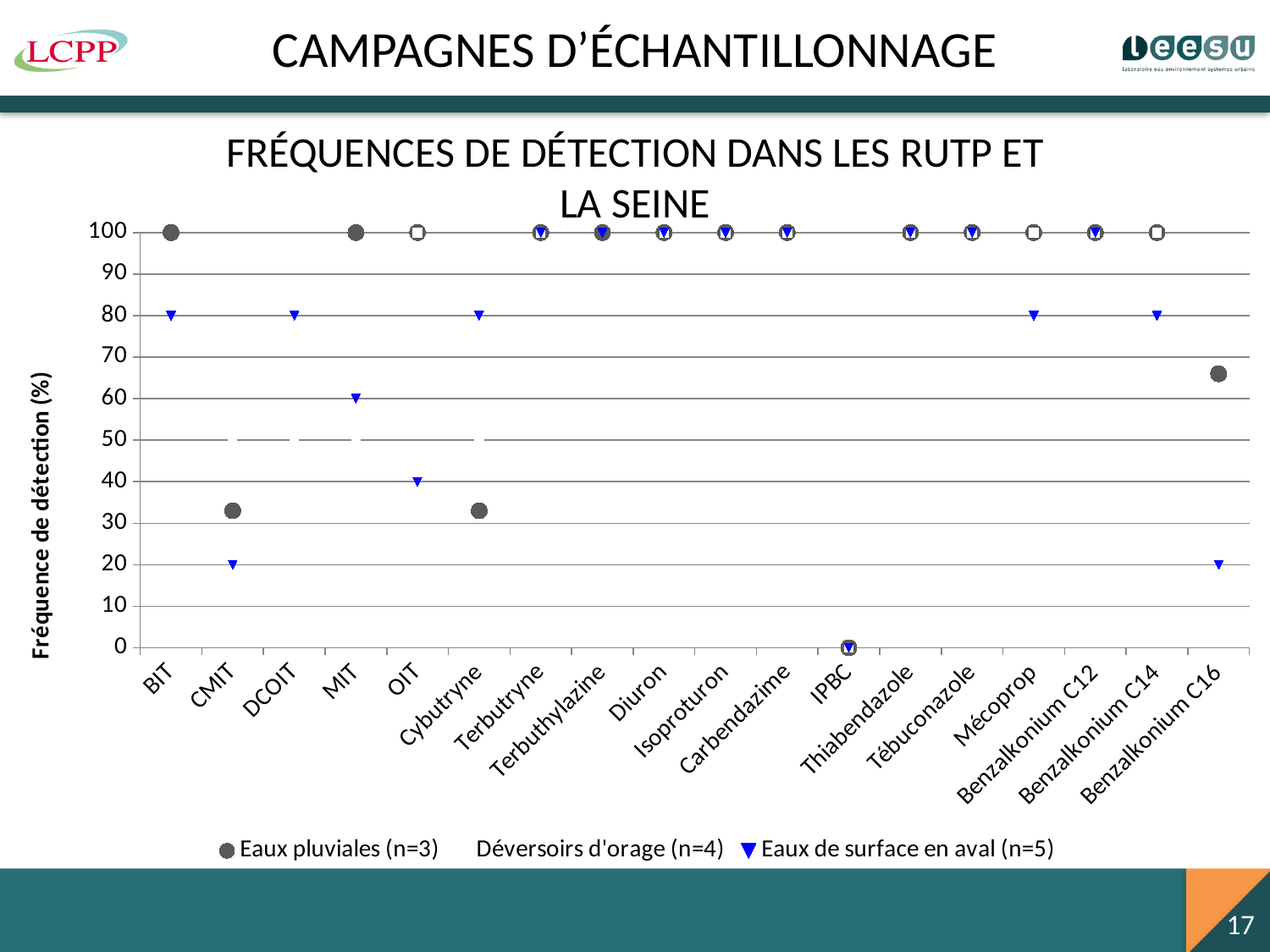
Is the Eaux pluviales (n=3) value for Benzalkonium C16 greater or less than 60? greater What is the value for OIT in the Eaux de surface en aval (n=5) series? 40 What is the label of the y axis? Fréquence de détection (%) How many series does the legend list? 3 What is the value for IPBC in the Eaux pluviales (n=3) series? 0 In the Eaux de surface en aval (n=5) series, which is larger: MIT or OIT? MIT How many categories are shown on the x axis? 18 What is the value for MIT in the Eaux de surface en aval (n=5) series? 60 Which category has the lowest value in the Eaux de surface en aval (n=5) series? IPBC What is the value for CMIT in the Eaux de surface en aval (n=5) series? 20 What is the value for BIT in the Eaux de surface en aval (n=5) series? 80 What is the difference between the Eaux de surface en aval (n=5) values for BIT and CMIT? 60